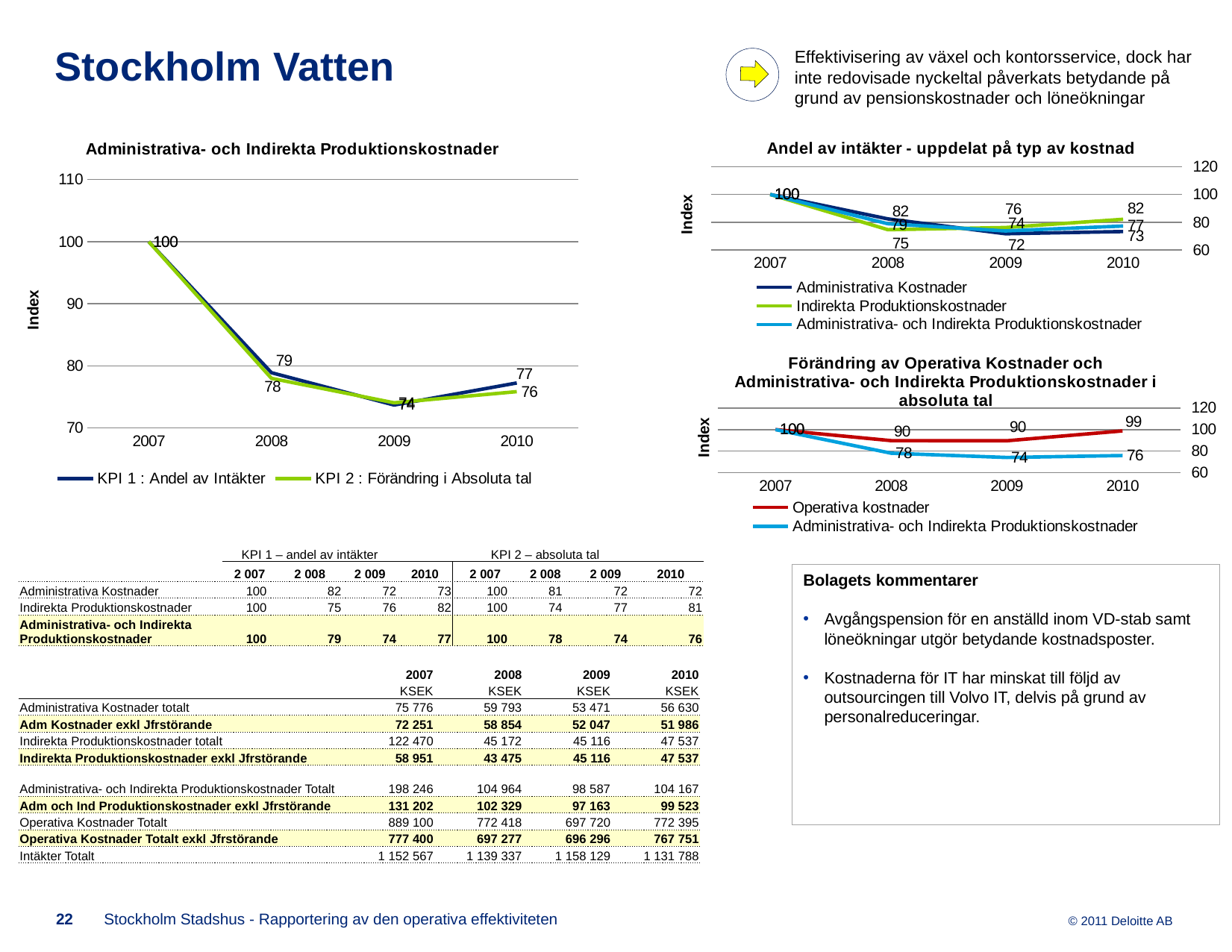
In the chart titled 'Andel av intäkter - uppdelat på typ av kostnad', what is the value of Indirekta Produktionskostnader in 2010? 82 In the chart titled 'Förändring av Operativa Kostnader och Administrativa- och Indirekta Produktionskostnader i absoluta tal', which series has the higher value in 2009, Operativa kostnader or Administrativa- och Indirekta Produktionskostnader? Operativa kostnader In the chart titled 'Administrativa- och Indirekta Produktionskostnader', in which year is KPI 1 : Andel av Intäkter lowest? 2009 In the chart titled 'Administrativa- och Indirekta Produktionskostnader', how many series does the legend list? 2 In the chart titled 'Andel av intäkter - uppdelat på typ av kostnad', what is the difference between Administrativa Kostnader and Indirekta Produktionskostnader in 2008? 7 In the chart titled 'Andel av intäkter - uppdelat på typ av kostnad', how many series does the legend list? 3 In the chart titled 'Administrativa- och Indirekta Produktionskostnader', what is the value of KPI 1 : Andel av Intäkter in 2010? 77 In the chart titled 'Andel av intäkter - uppdelat på typ av kostnad', what is the value of Administrativa Kostnader in 2008? 82 In the chart titled 'Administrativa- och Indirekta Produktionskostnader', what is the value of KPI 2 : Förändring i Absoluta tal in 2008? 78 What kind of chart is the chart titled 'Administrativa- och Indirekta Produktionskostnader'? Line chart In the chart titled 'Förändring av Operativa Kostnader och Administrativa- och Indirekta Produktionskostnader i absoluta tal', how many years are shown on the x axis? 4 In the chart titled 'Förändring av Operativa Kostnader och Administrativa- och Indirekta Produktionskostnader i absoluta tal', what is the value of Operativa kostnader in 2010? 99